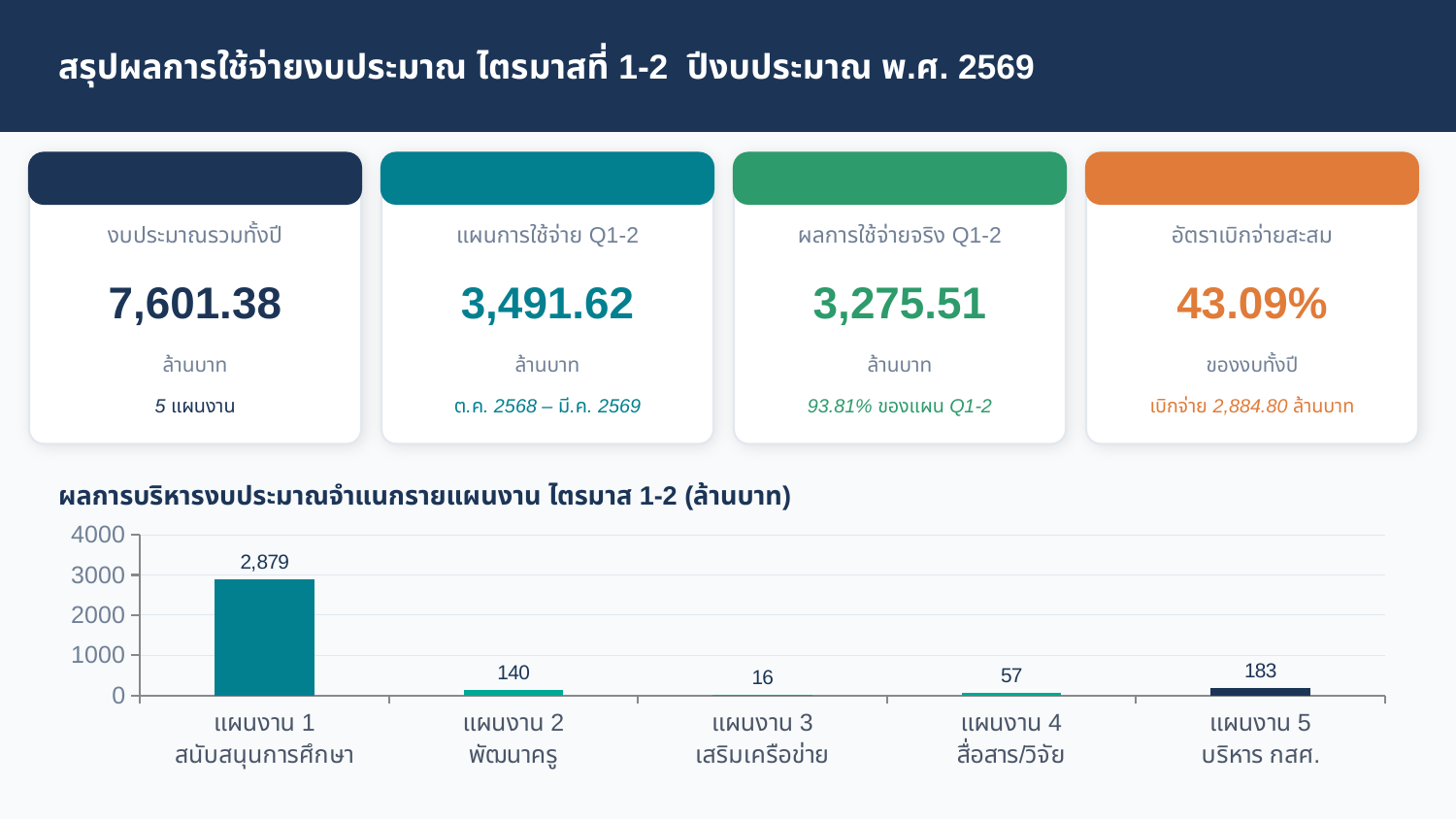
Is the value for แผนงาน 1 สนับสนุนการศึกษา greater or less than 2000? greater Which category has the highest value in the bar chart? แผนงาน 1 สนับสนุนการศึกษา What is the value for แผนงาน 3 เสริมเครือข่าย in the bar chart? 16 Which is larger, the value for แผนงาน 2 พัฒนาครู or แผนงาน 4 สื่อสาร/วิจัย? แผนงาน 2 พัฒนาครู What is the highest value shown on the y axis of the chart? 4000 How many categories are shown in the bar chart? 5 What is the difference between the values for แผนงาน 5 บริหาร กสศ. and แผนงาน 2 พัฒนาครู? 43 What is the value for แผนงาน 1 สนับสนุนการศึกษา in the bar chart? 2,879 What is the title of the chart? ผลการบริหารงบประมาณจำแนกรายแผนงาน ไตรมาส 1-2 (ล้านบาท) Which category has the lowest value in the bar chart? แผนงาน 3 เสริมเครือข่าย What is the value for แผนงาน 5 บริหาร กสศ. in the bar chart? 183 What kind of chart is shown on the slide? bar chart